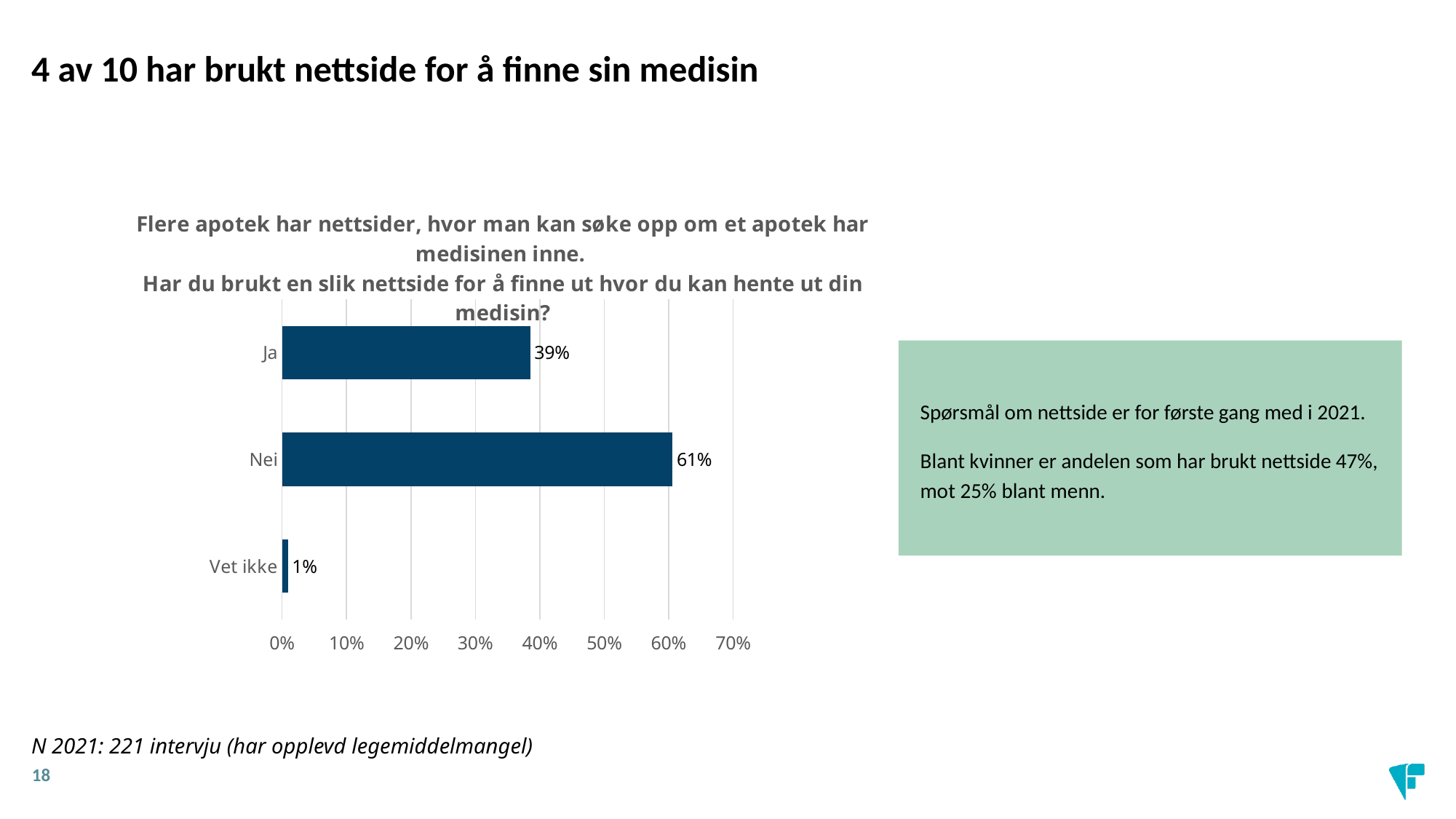
Is the value for "Ja" greater or less than 40%? less What is the value for "Ja"? 39% How many categories are shown in the chart? 3 What is the value for "Vet ikke"? 1% What is the difference between the values for "Nei" and "Ja"? 22% What kind of chart is shown on the slide? Bar chart Which category has the lowest value? Vet ikke Which category has the highest value? Nei What is the value for "Nei"? 61% Which is larger, the value for "Ja" or the value for "Nei"? Nei Is the value for "Nei" greater or less than 50%? greater What is the highest value shown on the chart's x axis? 70%